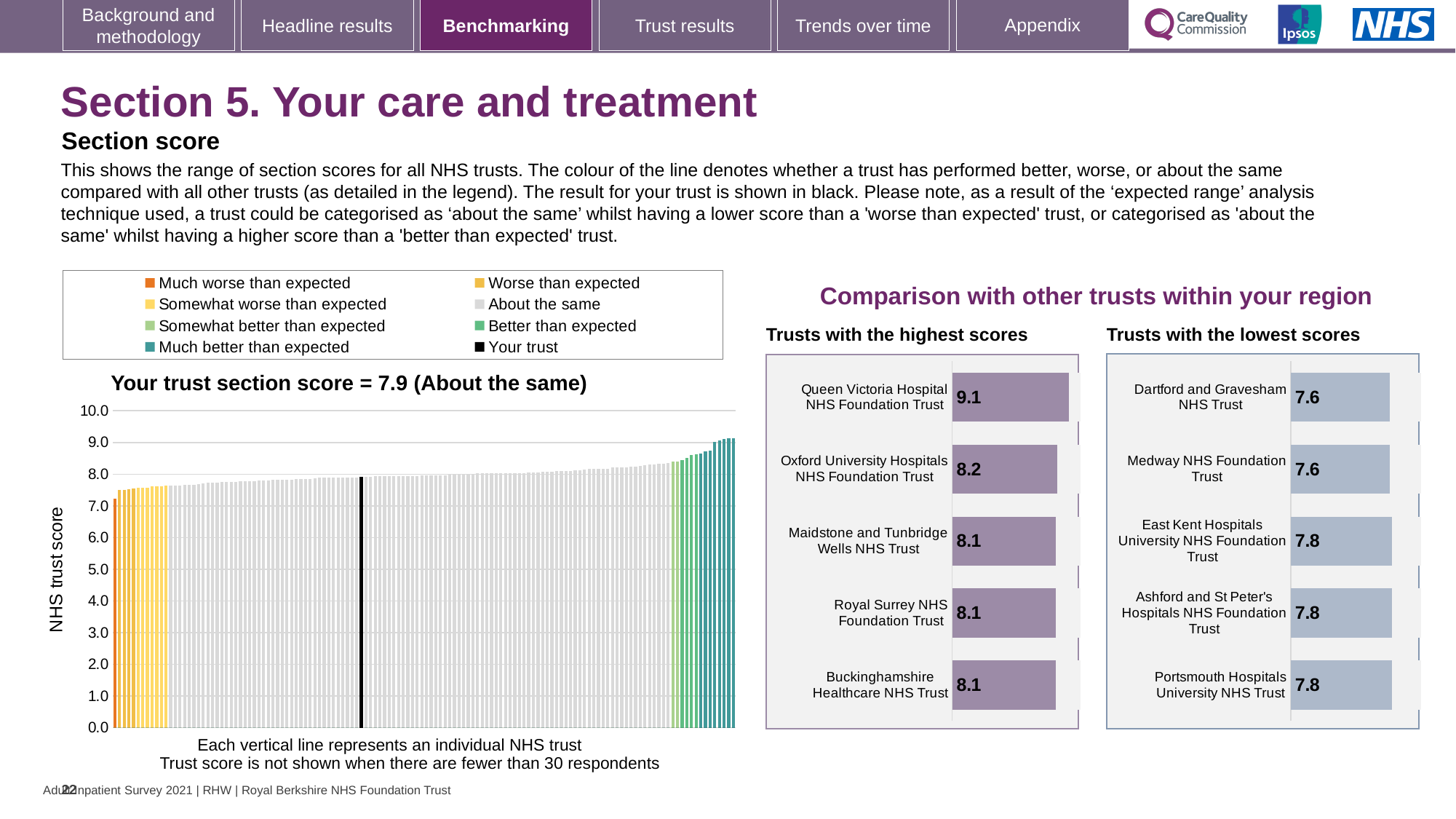
On the 'Your trust section score' chart, is the value of the leftmost bar greater or less than 8.0? less On the 'Your trust section score' chart, how many entries does the legend list? 8 On the 'Trusts with the lowest scores' chart, what is the score for Portsmouth Hospitals University NHS Trust? 7.8 On the 'Your trust section score' chart, what is the section score for your trust? 7.9 On the 'Trusts with the highest scores' chart, which trust has the highest score? Queen Victoria Hospital NHS Foundation Trust Which is larger: the score for Queen Victoria Hospital NHS Foundation Trust on the 'Trusts with the highest scores' chart or the score for Dartford and Gravesham NHS Trust on the 'Trusts with the lowest scores' chart? Queen Victoria Hospital NHS Foundation Trust On the 'Your trust section score' chart, do the trust scores rise or fall from left to right? Rise On the 'Your trust section score' chart, what kind of chart is shown? Bar chart On the 'Your trust section score' chart, what is the label of the vertical axis? NHS trust score On the 'Trusts with the highest scores' chart, what is the score for Queen Victoria Hospital NHS Foundation Trust? 9.1 On the 'Trusts with the lowest scores' chart, how many trusts are listed? 5 On the 'Trusts with the highest scores' chart, what is the difference between the scores of Queen Victoria Hospital NHS Foundation Trust and Oxford University Hospitals NHS Foundation Trust? 0.9